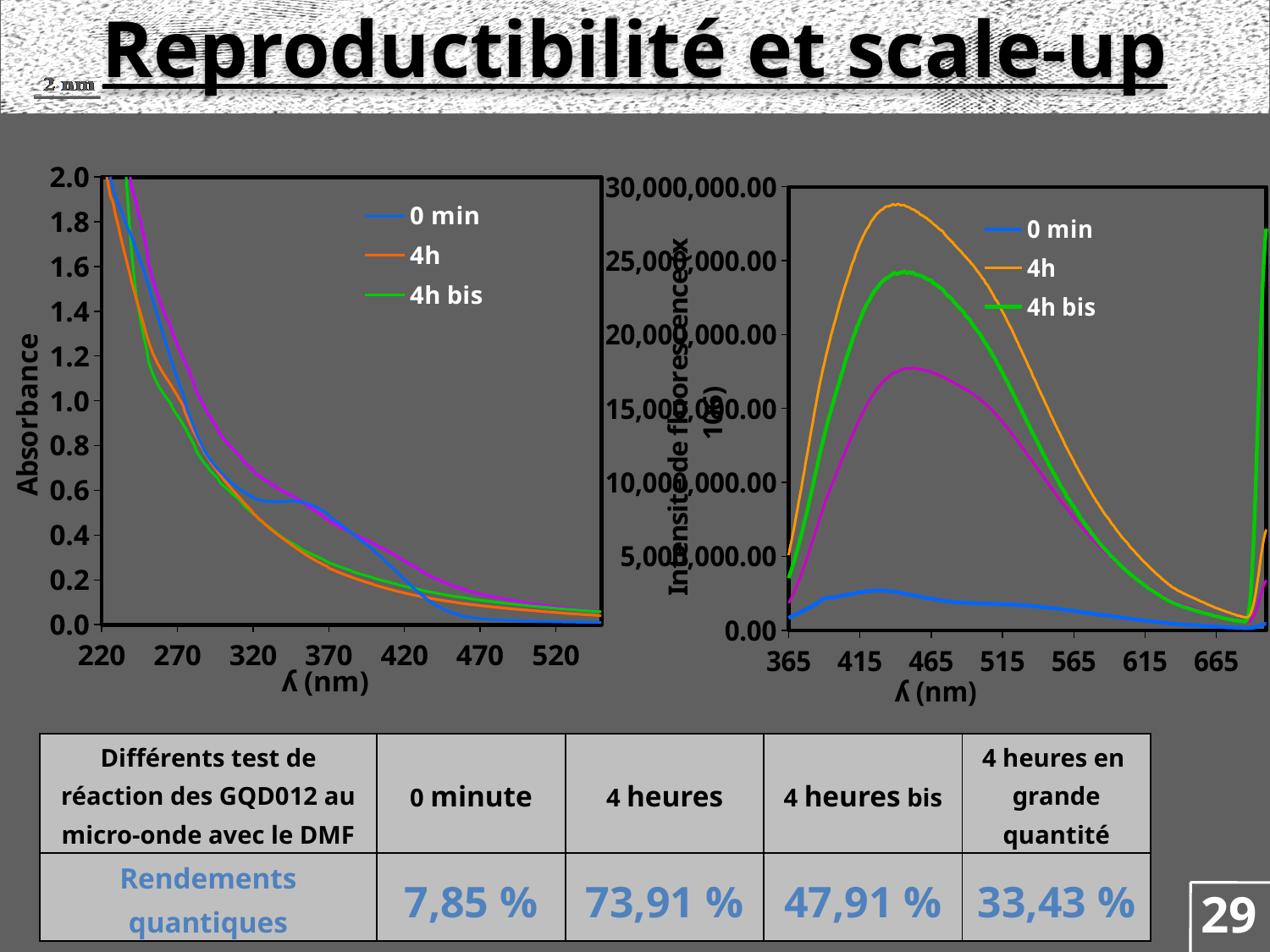
What is the label of the y axis of the left chart? Absorbance In the right chart, which series has the lowest intensity across the wavelength range? 0 min How many series does the legend of the left chart list? 3 In the right chart, is the peak value of the 0 min series greater or less than 5,000,000.00? less In the right chart, which series reaches the highest peak intensity? 4h In the left chart, is the absorbance of the 4h series at 420 nm greater or less than 0.4? less What kind of chart is the right chart (Intensité de fluorescence vs ʎ (nm))? line chart What are the legend entries of the right chart? 0 min, 4h, 4h bis In the right chart, at 465 nm, which series has the larger intensity, 4h or 4h bis? 4h What kind of chart is the left chart (Absorbance vs ʎ (nm))? line chart In the right chart, is the peak value of the 4h series greater or less than 25,000,000.00? greater In the left chart, does the absorbance of the 4h series rise or fall as the wavelength increases from 220 nm to 520 nm? fall